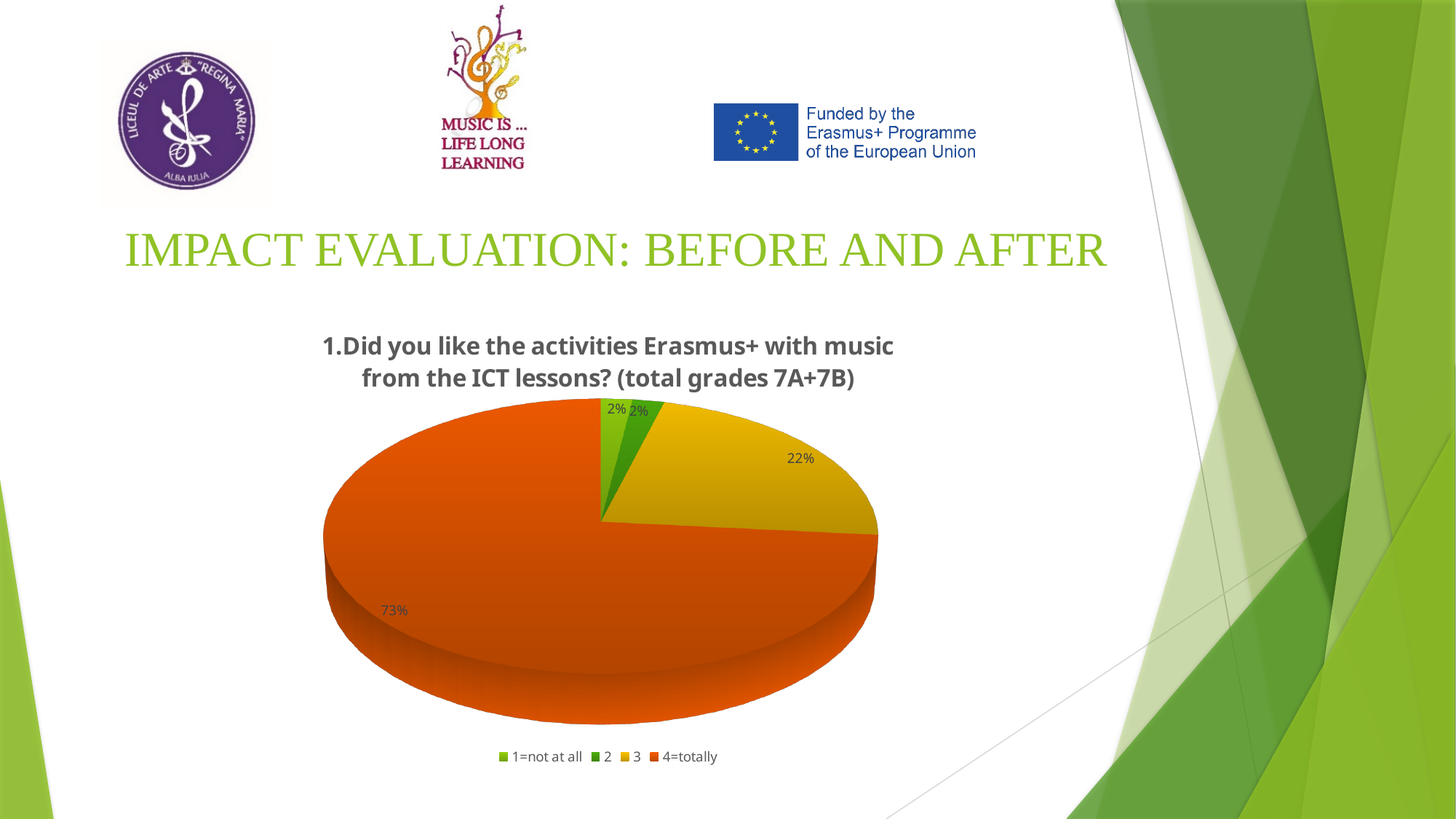
How many slices does the pie chart have? 4 What share of the pie does the "2" slice represent? 2% Which slice is larger, "3" or "4=totally"? 4=totally Which category has the largest slice of the pie? 4=totally What share of the pie does the "3" slice represent? 22% What colour is the "4=totally" slice in the pie chart? orange What share of the pie does the "1=not at all" slice represent? 2% What kind of chart is shown on the slide? pie chart What is the title of the pie chart? 1.Did you like the activities Erasmus+ with music from the ICT lessons? (total grades 7A+7B) How many entries does the legend list? 4 What is the difference in percentage points between the "4=totally" slice and the "3" slice? 51